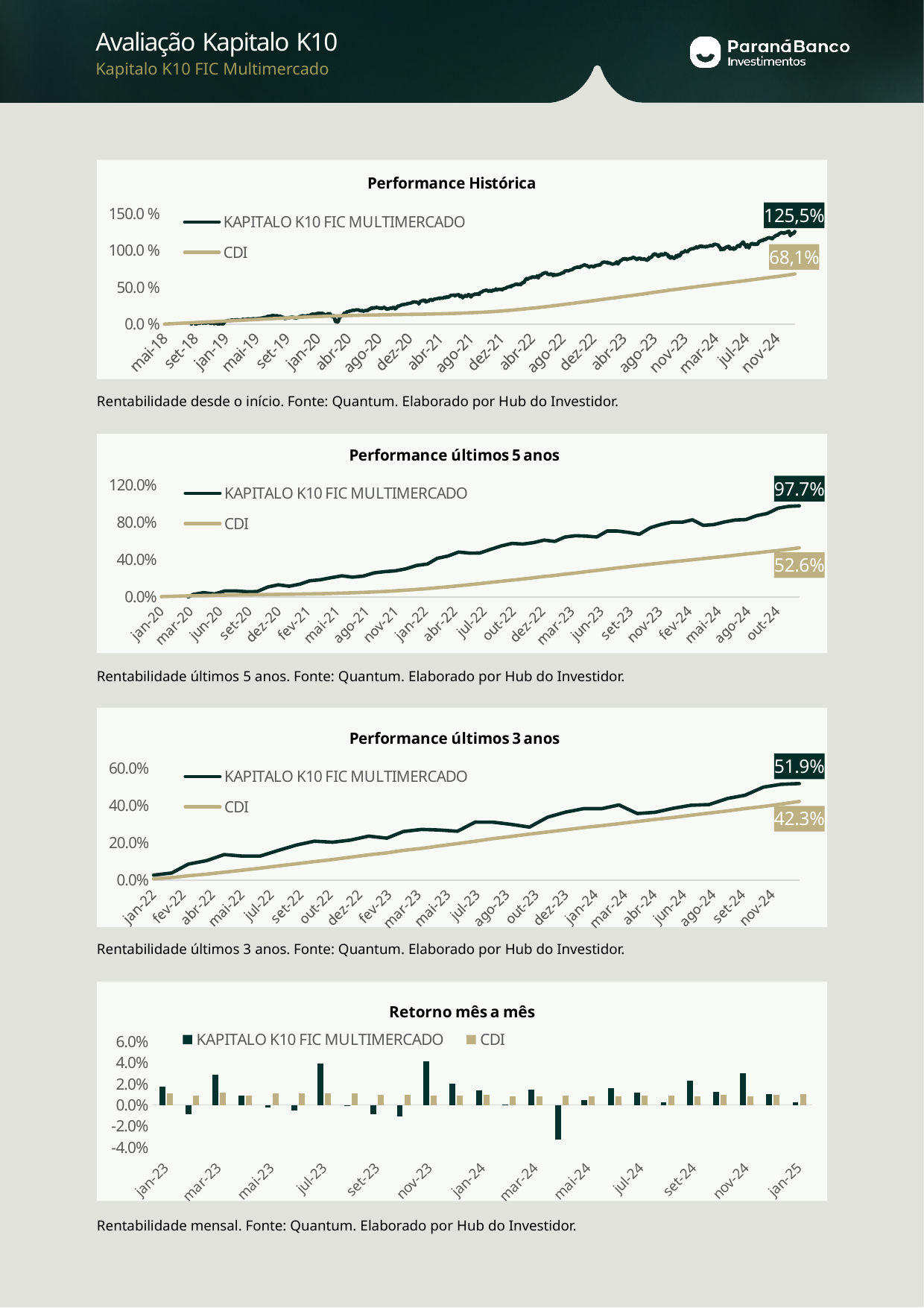
What kind of chart is 'Performance últimos 5 anos'? Line chart In the 'Performance Histórica' chart, what is the final value shown for CDI? 68,1% In the 'Performance últimos 5 anos' chart, what is the final value shown for KAPITALO K10 FIC MULTIMERCADO? 97.7% In the 'Performance últimos 3 anos' chart, what is the difference between the final values of KAPITALO K10 FIC MULTIMERCADO (51.9%) and CDI (42.3%)? 9.6% In the 'Performance últimos 5 anos' chart, what is the final value shown for CDI? 52.6% What kind of chart is 'Retorno mês a mês'? Bar chart In the 'Performance Histórica' chart, does the KAPITALO K10 FIC MULTIMERCADO line generally rise or fall from mai-18 to nov-24? Rise In the 'Retorno mês a mês' chart, is the KAPITALO K10 FIC MULTIMERCADO value for jul-23 greater or less than 2.0%? greater In the 'Performance Histórica' chart, what is the difference between the final values of KAPITALO K10 FIC MULTIMERCADO and CDI? 57,4% How many series does the legend of the 'Performance Histórica' chart list? 2 In the 'Performance Histórica' chart, what is the final value shown for KAPITALO K10 FIC MULTIMERCADO? 125,5% In the 'Performance últimos 3 anos' chart, which series ends higher, KAPITALO K10 FIC MULTIMERCADO or CDI? KAPITALO K10 FIC MULTIMERCADO